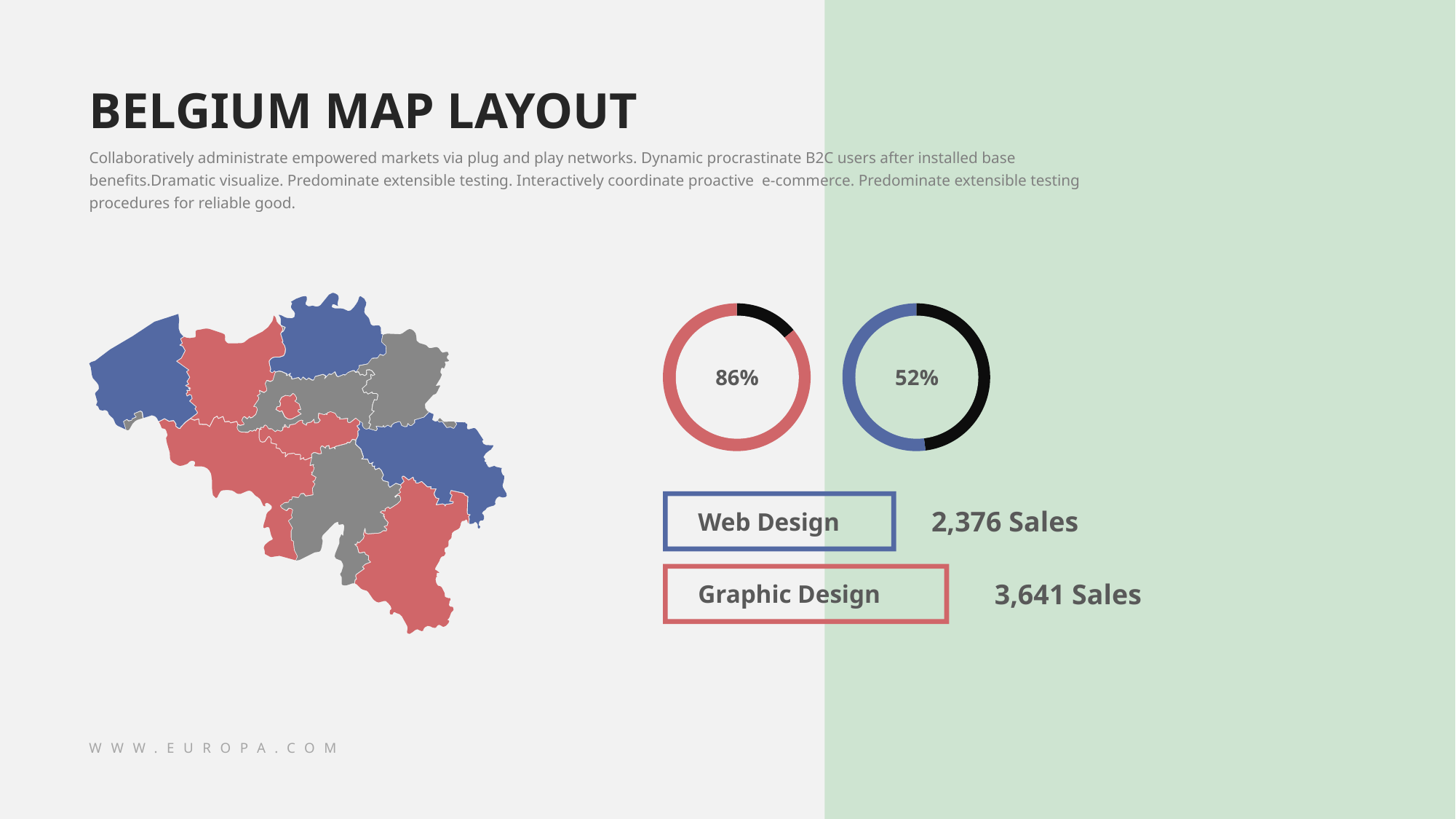
How many ring charts are shown on the slide? 2 Is the value shown in the left ring chart greater or less than 90%? less How many sales are listed next to the Web Design label below the ring charts? 2,376 Sales How many sales are listed next to the Graphic Design label below the ring charts? 3,641 Sales What colour is the filled portion of the ring chart showing 52%? blue What value is shown in the centre of the left (red) ring chart? 86% What colour is the filled portion of the ring chart showing 86%? red What is the difference between the percentages shown in the left and right ring charts? 34% What kind of chart is used to display the 86% and 52% values? ring (donut) chart Is the value shown in the right ring chart greater or less than 50%? greater Which of the two ring charts shows the higher percentage, the left red one or the right blue one? the left red one What value is shown in the centre of the right (blue) ring chart? 52%